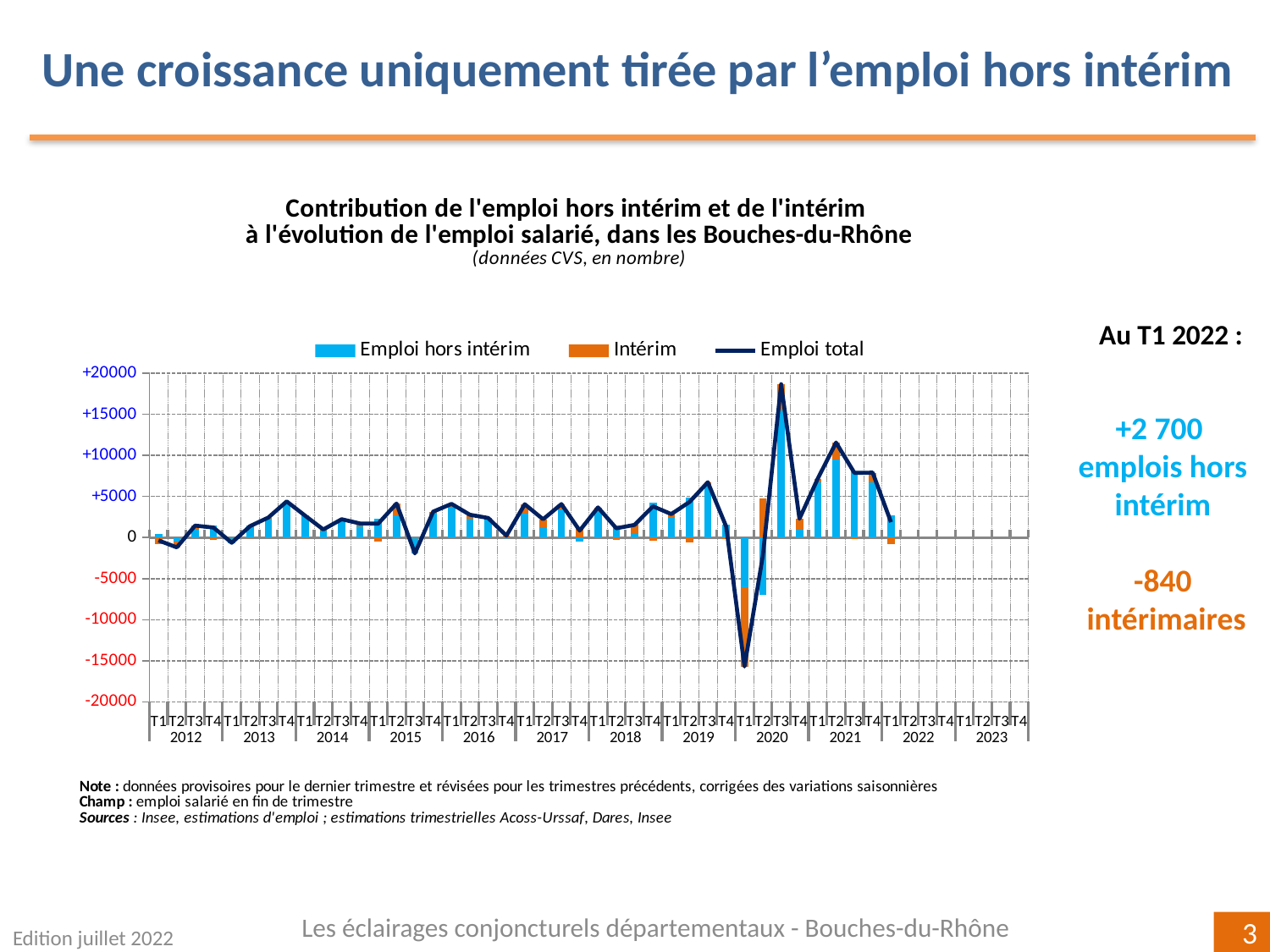
In which quarter does the 'Emploi total' line reach its lowest point? T1 2020 Is the 'Emploi hors intérim' bar at T2 2021 greater or less than 5000? greater According to the slide, what is the contribution of 'emplois hors intérim' at T1 2022? +2 700 What kind of chart is shown on the slide? A combined bar and line chart Which is larger, the 'Emploi total' value at T3 2020 or at T2 2021? T3 2020 Is the value of 'Emploi total' at T3 2020 greater or less than 15000? greater Which colour represents the 'Intérim' series in the chart? Orange According to the slide, what is the contribution of 'intérimaires' at T1 2022? -840 Between T1 2020 and T3 2020, does the 'Emploi total' line rise or fall? rise Is the value of 'Emploi total' at T1 2020 greater or less than -10000? less In which quarter does the 'Emploi total' line reach its highest point? T3 2020 How many series does the chart legend list? 3